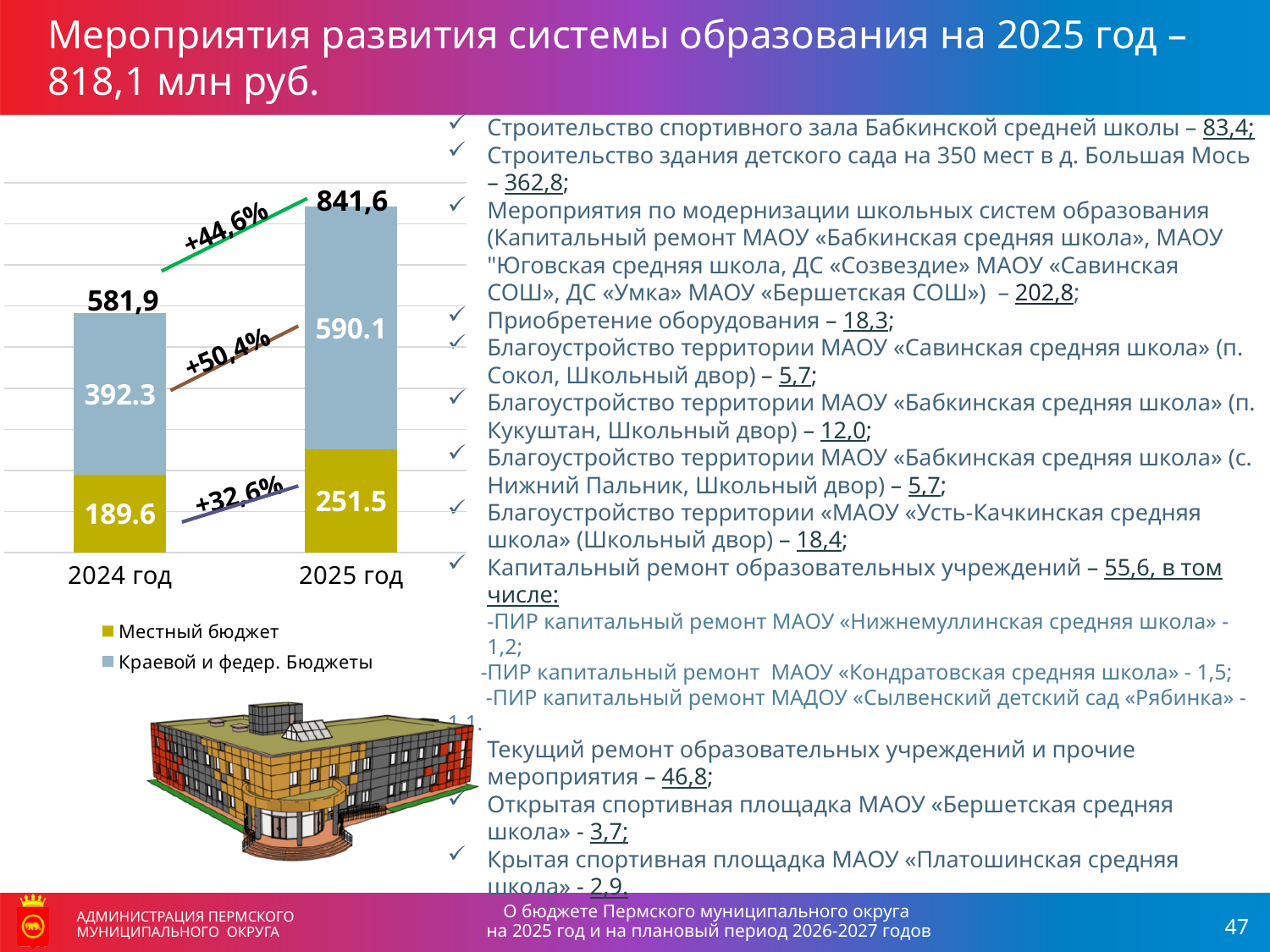
What is the difference between the Местный бюджет values for 2025 год and 2024 год? 61.9 What is the value of Краевой и федер. Бюджеты for 2024 год? 392.3 How many categories (years) are shown on the x axis of the chart? 2 What percentage change is shown between the totals of 2024 год and 2025 год? +44,6% Which year has the higher total value in the chart? 2025 год What type of chart is shown on the slide? stacked bar chart What is the value of Краевой и федер. Бюджеты for 2025 год? 590.1 What is the total of the stacked bar for 2024 год? 581,9 What is the total of the stacked bar for 2025 год? 841,6 How many series does the chart legend list? 2 What is the value of Местный бюджет for 2025 год? 251.5 What is the value of Местный бюджет for 2024 год? 189.6